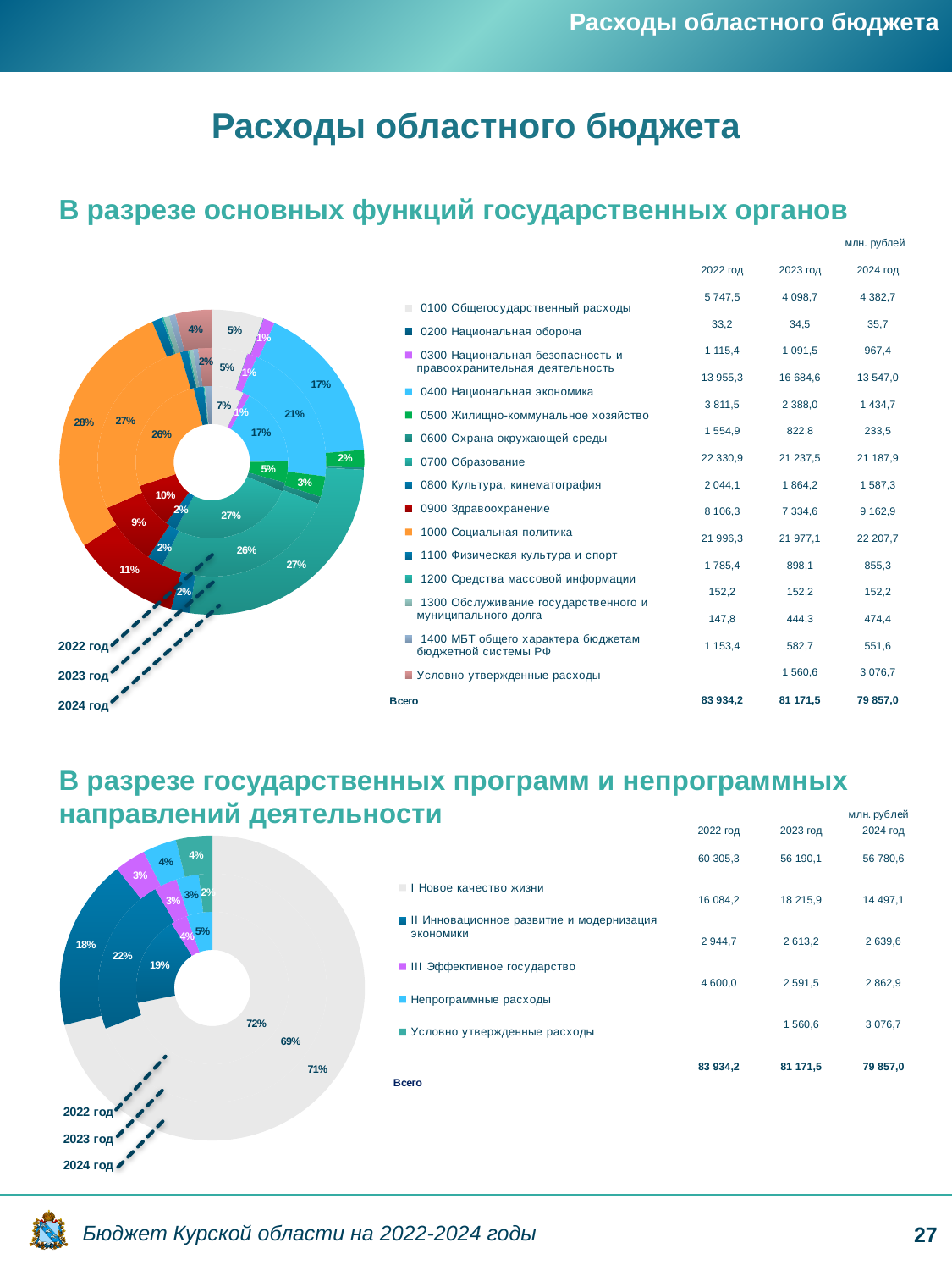
In the table for 'В разрезе государственных программ и непрограммных направлений деятельности', what is the value for I Новое качество жизни in 2023 год? 56 190,1 What kind of chart is shown in the section 'В разрезе основных функций государственных органов'? doughnut chart In the chart 'В разрезе государственных программ и непрограммных направлений деятельности', what share does I Новое качество жизни have in the 2024 год ring? 71% In the table for 'В разрезе основных функций государственных органов', which category has the lowest value in 2022 год? 0200 Национальная оборона In the table for 'В разрезе основных функций государственных органов', which category has the highest value in 2024 год? 1000 Социальная политика In the table for 'В разрезе основных функций государственных органов', what is the difference between Всего for 2022 год and Всего for 2024 год? 4 077,2 In the chart 'В разрезе основных функций государственных органов', how many entries does the legend list? 15 In the table for 'В разрезе государственных программ и непрограммных направлений деятельности', by how much does II Инновационное развитие и модернизация экономики in 2023 год exceed its value in 2022 год? 2 131,7 In the table for 'В разрезе основных функций государственных органов', which is larger in 2024 год: 0900 Здравоохранение or 0100 Общегосударственный расходы? 0900 Здравоохранение In the chart 'В разрезе государственных программ и непрограммных направлений деятельности', how many entries does the legend list? 5 In the table for 'В разрезе основных функций государственных органов', what is the value for 0700 Образование in 2022 год? 22 330,9 In the table for 'В разрезе основных функций государственных органов', what is the value for 0400 Национальная экономика in 2023 год? 16 684,6